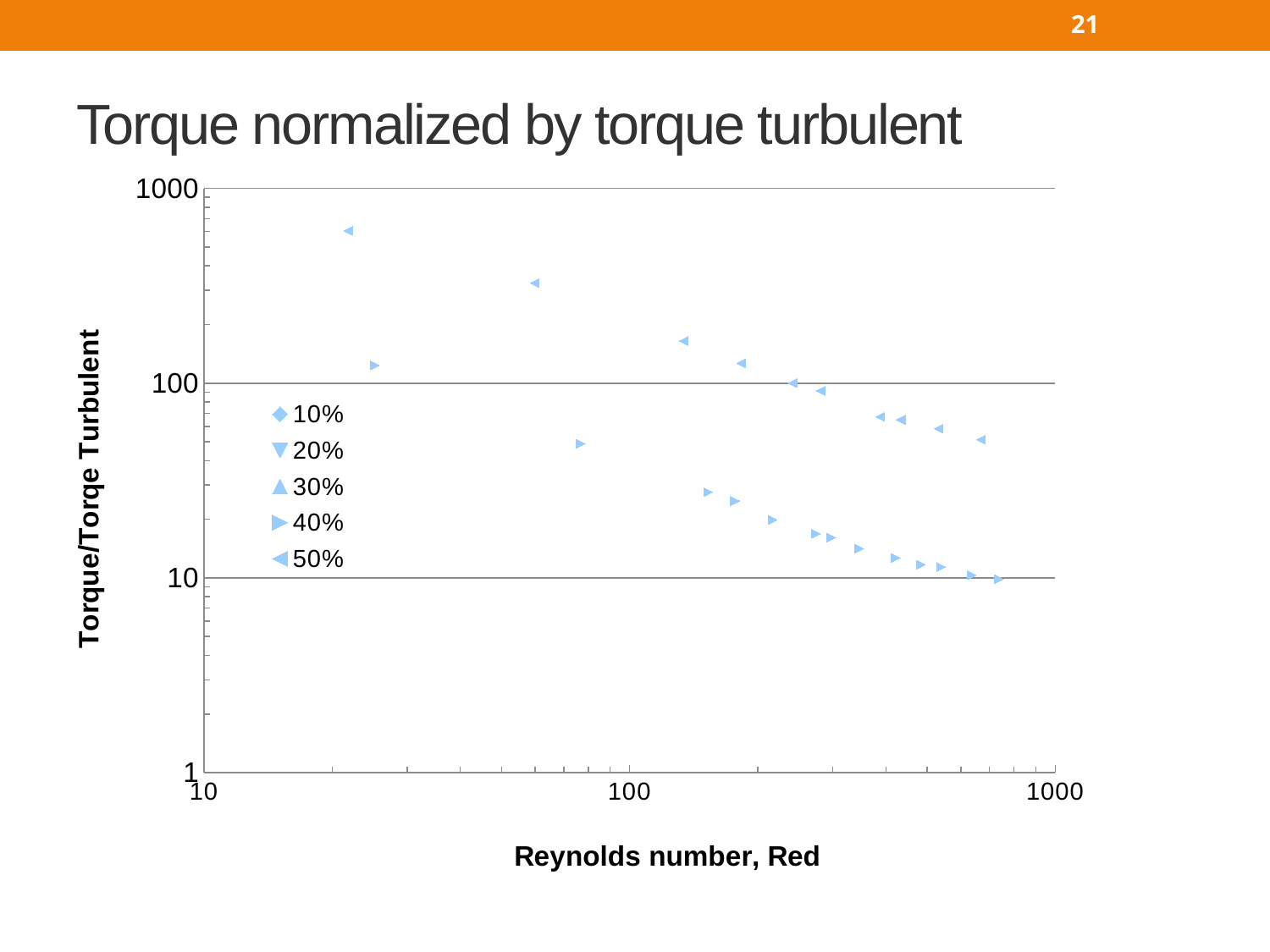
At a Reynolds number of about 200, which series has the larger value, 40% or 50%? 50% Which series has the lowest plotted value on the chart? 40% How many series does the legend list? 5 Is the value of the 40% series at its highest Reynolds number greater or less than 100? less What kind of chart is shown on the slide? scatter chart Is the value of the 50% series at its lowest Reynolds number greater or less than 100? greater Do the plotted values rise or fall as the Reynolds number increases? fall Is the value of the 50% series at its highest Reynolds number greater or less than 10? greater Which series has the highest plotted value on the chart? 50% What is the label of the x axis? Reynolds number, Red What is the title of the chart? Torque normalized by torque turbulent